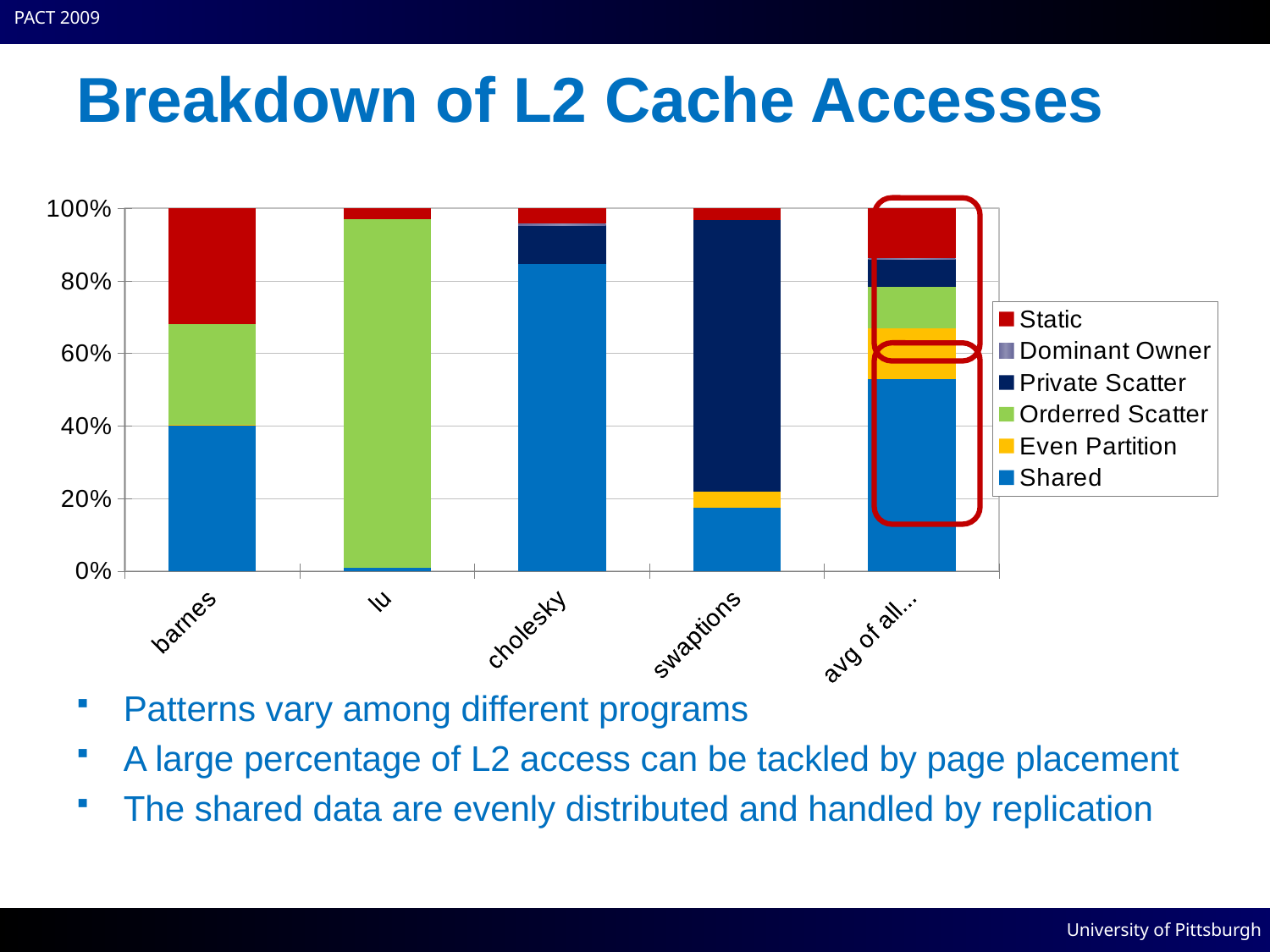
Which category has the smallest Shared segment? lu How many categories are shown along the x axis of the chart? 5 How many series does the chart's legend list? 6 What is the title of the chart on the slide? Breakdown of L2 Cache Accesses Is the Shared value for cholesky greater or less than 80%? greater Is the Shared value for swaptions greater or less than 20%? less Which is larger, the Shared segment for cholesky or for swaptions? cholesky Is the Shared value for avg of all... greater or less than 40%? greater Which category has the largest Static segment? barnes Which category has the largest Private Scatter segment? swaptions What kind of chart is shown on the slide? Stacked bar chart Which category has the largest Shared segment? cholesky